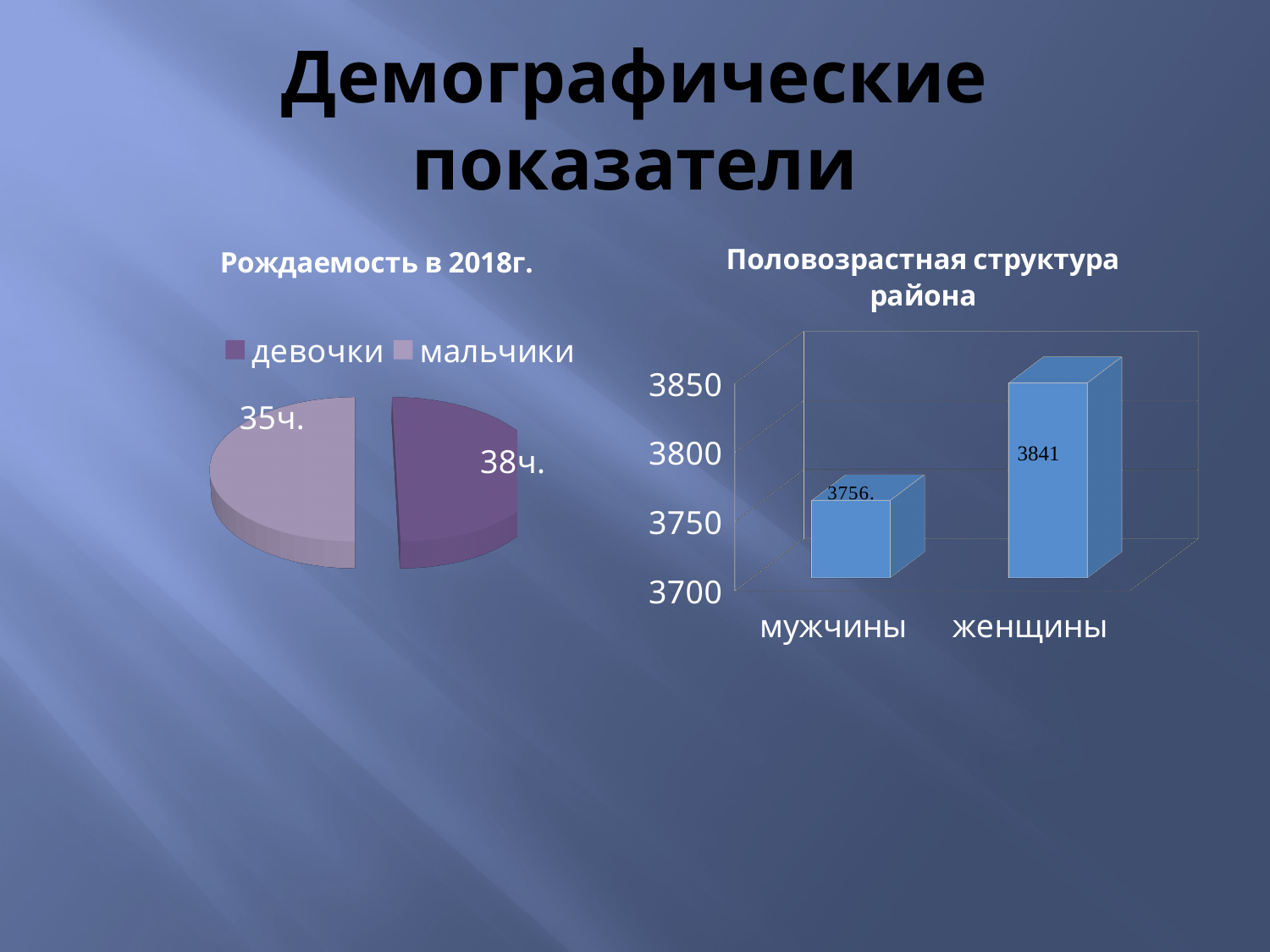
In the chart titled "Половозрастная структура района", what is the value for женщины? 3841 In the chart titled "Половозрастная структура района", what is the value for мужчины? 3756 In the chart titled "Рождаемость в 2018г.", what is the value for мальчики? 35ч. What kind of chart is the one titled "Половозрастная структура района"? bar chart In the chart titled "Рождаемость в 2018г.", what is the value for девочки? 38ч. In the chart titled "Половозрастная структура района", what is the difference between the values for женщины and мужчины? 85 How many entries does the legend of the chart titled "Рождаемость в 2018г." list? 2 In the chart titled "Рождаемость в 2018г.", which category has the larger value, девочки or мальчики? девочки In the chart titled "Половозрастная структура района", which category has the highest value? женщины What kind of chart is the one titled "Рождаемость в 2018г."? pie chart In the chart titled "Рождаемость в 2018г.", what is the difference between the values for девочки and мальчики? 3 How many categories are shown in the chart titled "Половозрастная структура района"? 2